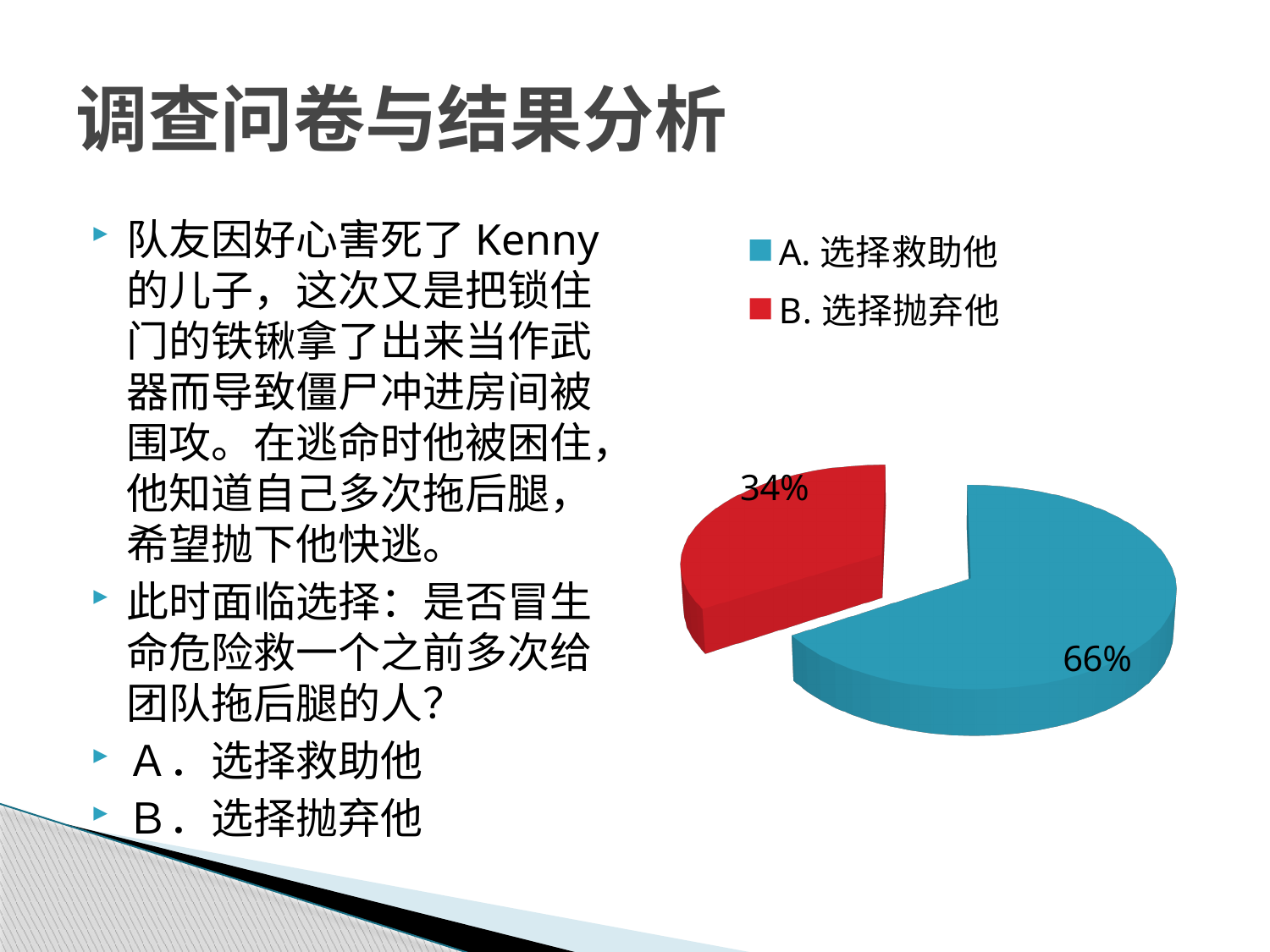
What colour is the slice for "A. 选择救助他"? blue What percentage is shown for "A. 选择救助他"? 66% What is the difference in percentage points between "A. 选择救助他" and "B. 选择抛弃他"? 32 Which is larger, the share for "A. 选择救助他" or the share for "B. 选择抛弃他"? A. 选择救助他 Which option has the largest share of the pie? A. 选择救助他 What kind of chart is shown on the slide? pie chart How many slices does the pie chart have? 2 What share of the pie does "B. 选择抛弃他" represent? 34% How many entries does the legend list? 2 What percentage is shown for "B. 选择抛弃他"? 34% Which option has the smallest share of the pie? B. 选择抛弃他 What colour is the slice for "B. 选择抛弃他"? red